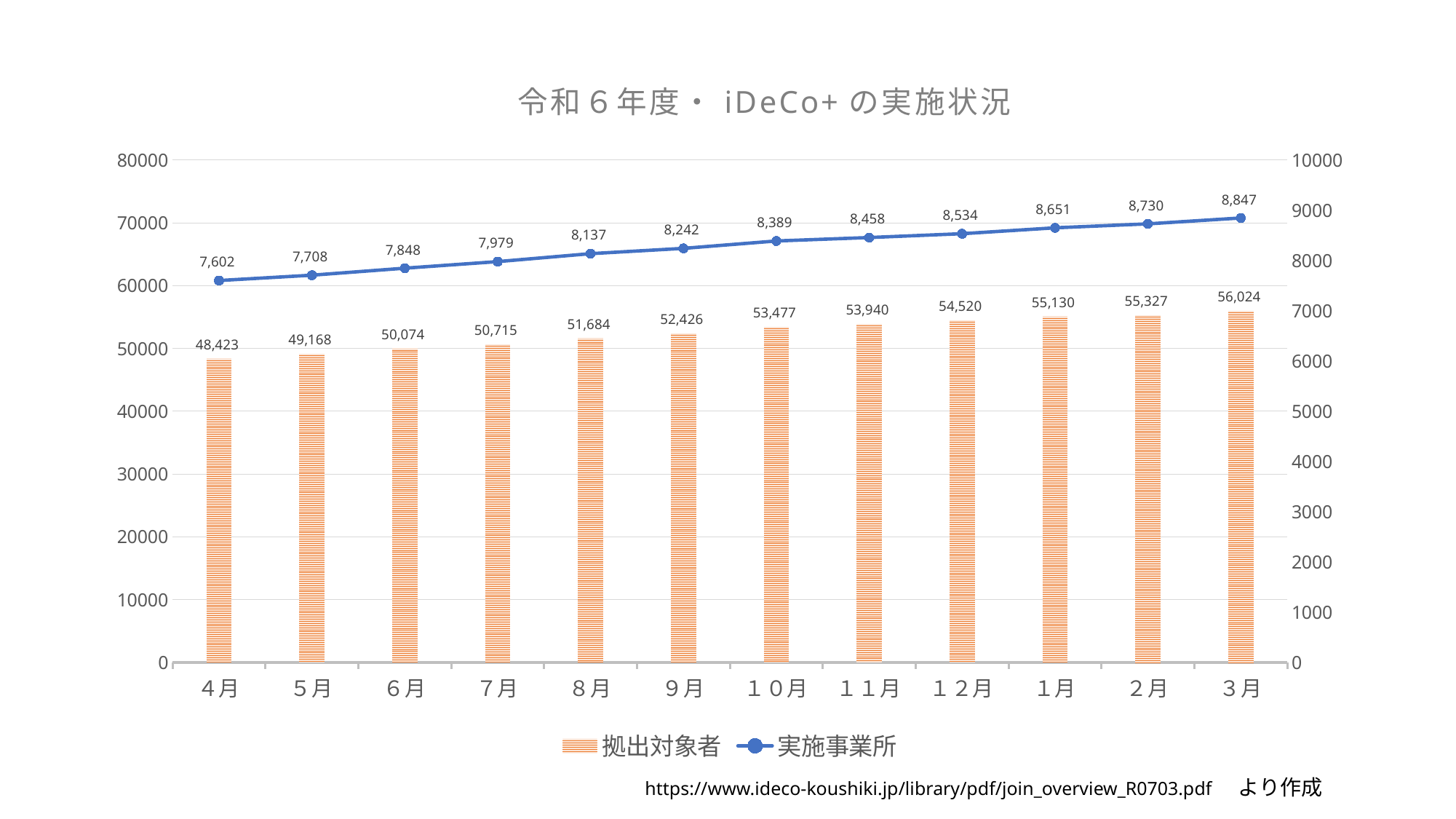
What is the value of 拠出対象者 for 10月? 53,477 What is the difference between the 拠出対象者 values for 3月 and 4月? 7,601 How many series does the legend list? 2 What is the difference between the 実施事業所 values for 2月 and 1月? 79 Does the 実施事業所 series rise or fall from 4月 to 3月? rise What is the value of 拠出対象者 for 4月? 48,423 Which month has the lowest value for 実施事業所? 4月 What is the value of 実施事業所 for 8月? 8,137 How many months are shown on the x axis? 12 What is the value of 実施事業所 for 3月? 8,847 Which is larger, the 拠出対象者 value for 9月 or for 7月? 9月 Which month has the highest value for 拠出対象者? 3月